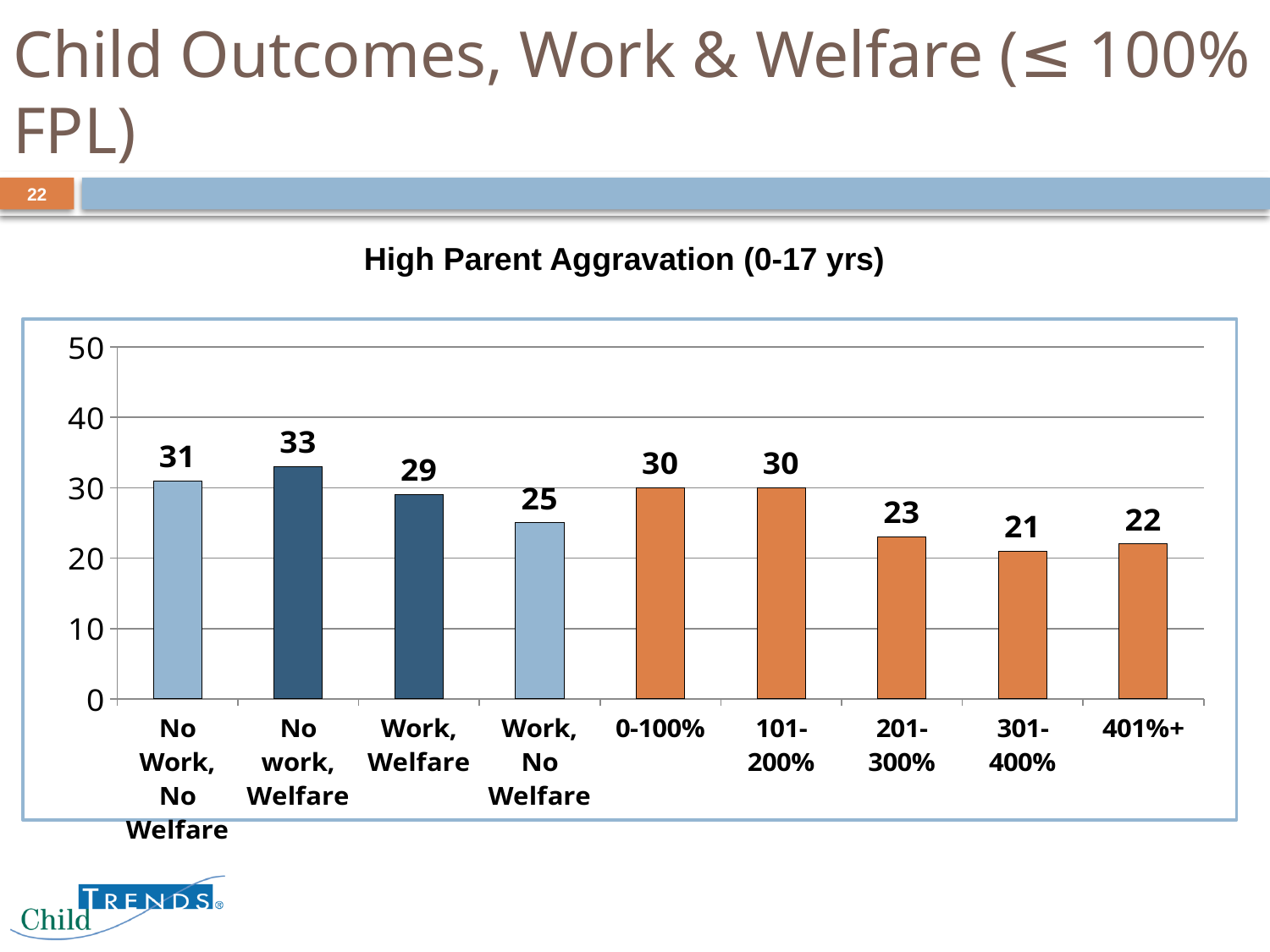
What is the title of the chart? High Parent Aggravation (0-17 yrs) Which category has the highest value? No work, Welfare What is the value for the 'Work, No Welfare' category? 25 What is the difference between the values for '0-100%' and '401%+'? 8 Is the value for '201-300%' greater or less than 30? less What kind of chart is shown on the slide? bar chart What is the difference between the values for 'No work, Welfare' and 'Work, No Welfare'? 8 What is the value for the 'No work, Welfare' category? 33 Which category has the lowest value? 301-400% What is the value for the '301-400%' category? 21 How many categories are shown on the x axis? 9 Which is larger, the value for 'No Work, No Welfare' or the value for 'Work, Welfare'? No Work, No Welfare